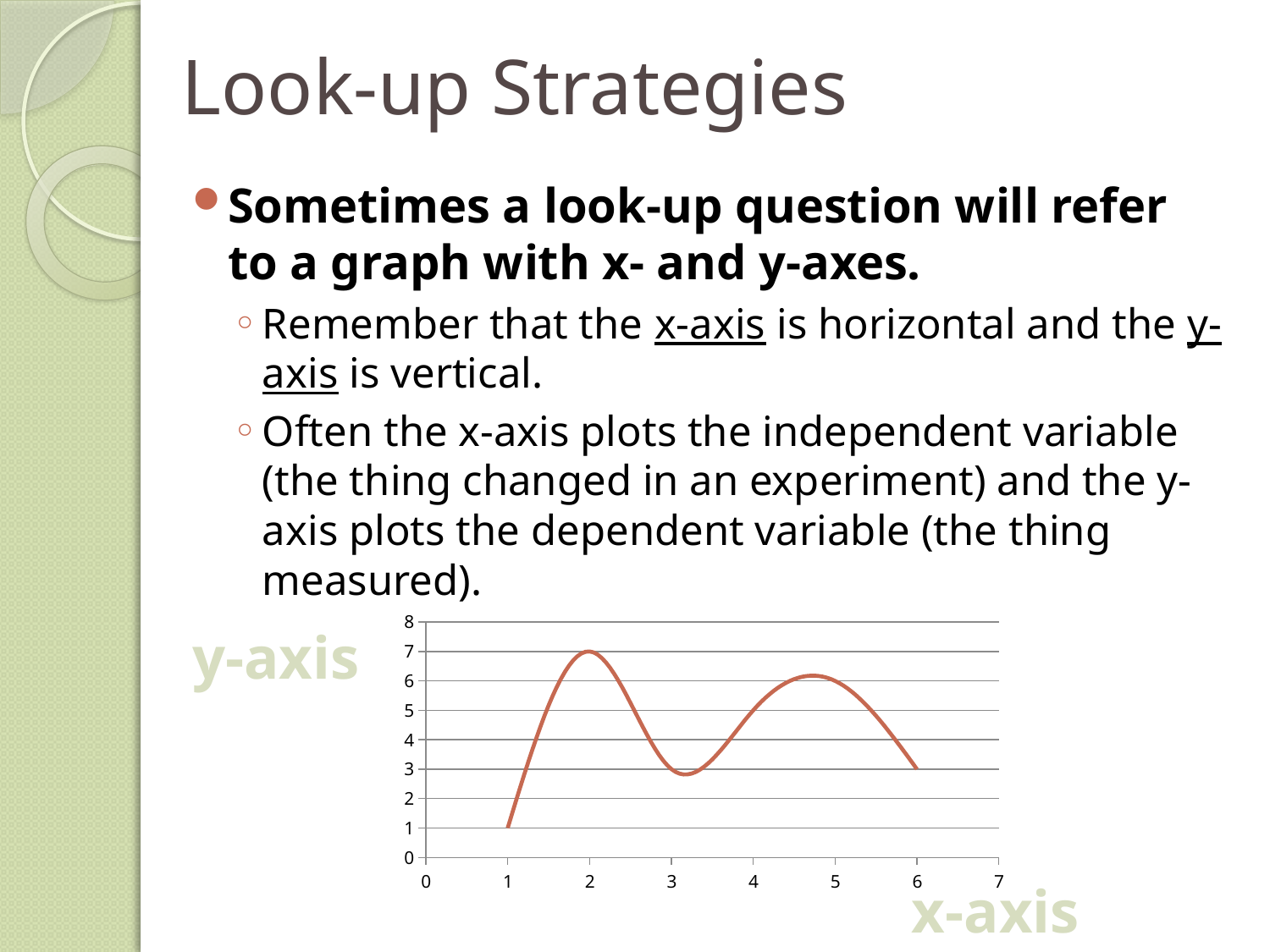
What is the y value of the line at x = 2? 7 At which x value does the line reach its lowest point? 1 What is the y value of the line at x = 6? 3 Is the y value at x = 3 greater or less than 5? less What kind of chart is shown on the slide? line chart Does the line rise or fall between x = 1 and x = 2? rise What is the difference between the y value at x = 2 and the y value at x = 1? 6 At which x value does the line reach its highest point? 2 Which is larger, the y value at x = 2 or the y value at x = 6? x = 2 What is the y value of the line at x = 1? 1 What is the highest value shown on the y-axis? 8 Is the y value at x = 5 greater or less than 5? greater